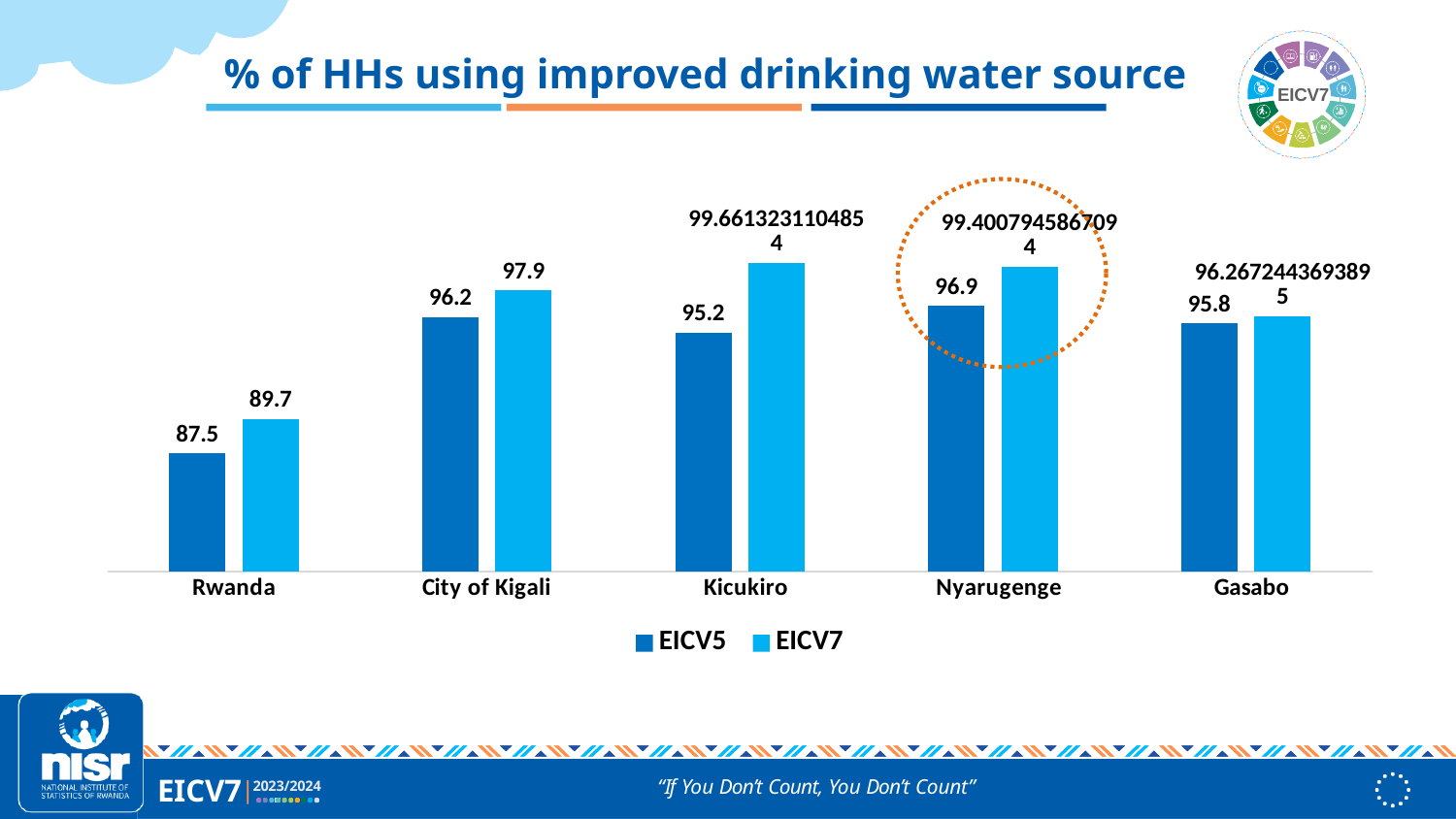
What is the EICV5 value for Gasabo? 95.8 What is the difference between the EICV7 and EICV5 values for Rwanda? 2.2 How many series does the legend list? 2 What is the difference between the EICV7 and EICV5 values for City of Kigali? 1.7 Which category has the lowest EICV7 value? Rwanda What is the EICV5 value for Rwanda? 87.5 What is the EICV5 value for Nyarugenge? 96.9 Which category has the highest EICV5 value? Nyarugenge How many categories are shown on the x axis? 5 What is the EICV7 value for City of Kigali? 97.9 What kind of chart is shown on the slide? Bar chart Which has the larger EICV5 value, Kicukiro or Nyarugenge? Nyarugenge